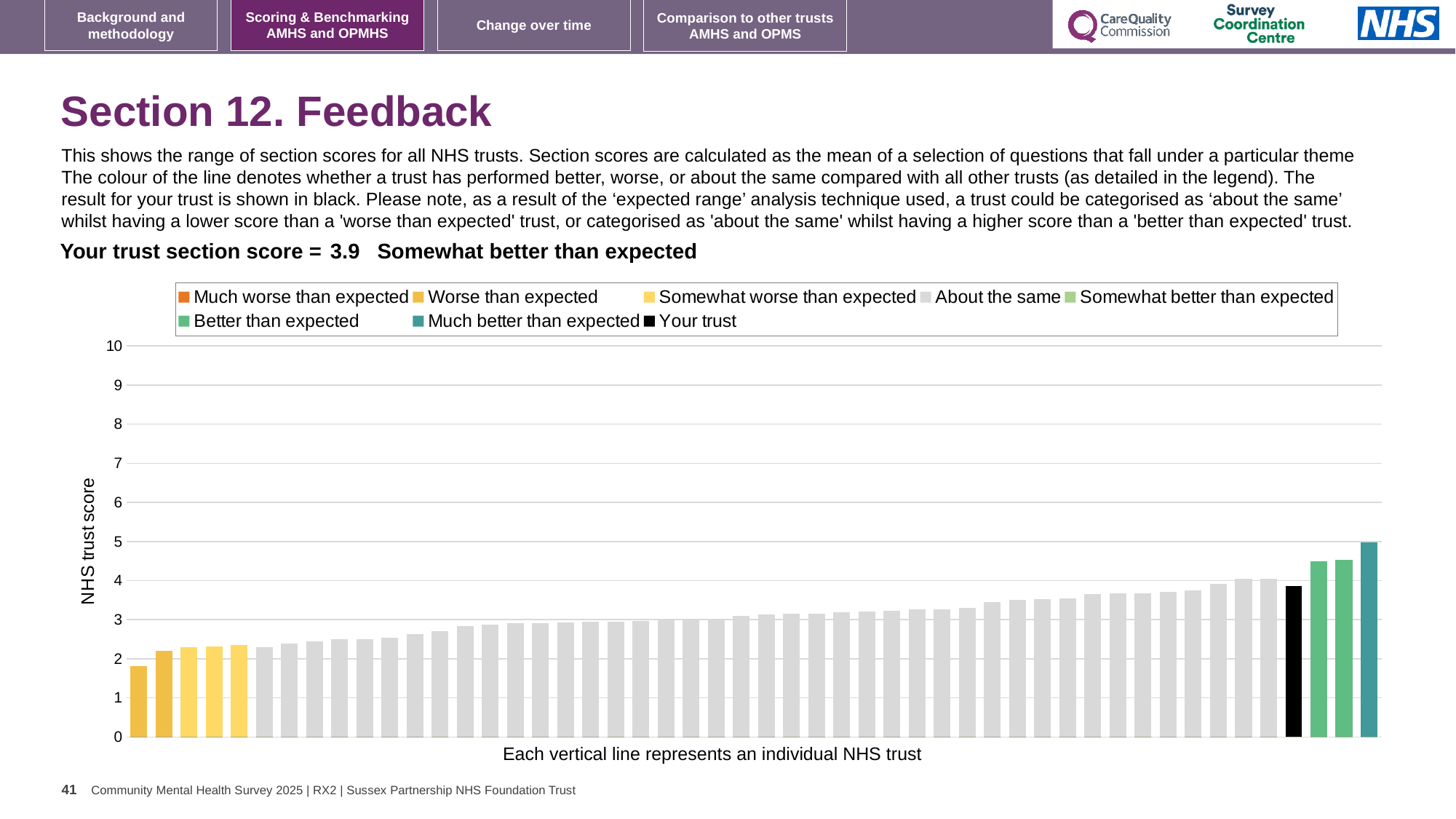
What is the title of the vertical axis? NHS trust score Is the value for your trust greater or less than 4? less How many entries does the chart legend list? 8 Is the value of the tallest bar greater or less than 4? greater Is the value of the shortest bar greater or less than 3? less What colour is the bar representing your trust? black Which legend category does the tallest bar belong to? Much better than expected What kind of chart is shown on the slide? bar chart Which benchmark category is your trust's section score placed in? Somewhat better than expected What is the section score for your trust shown on the slide? 3.9 Do the bar values rise or fall from left to right along the x axis? rise